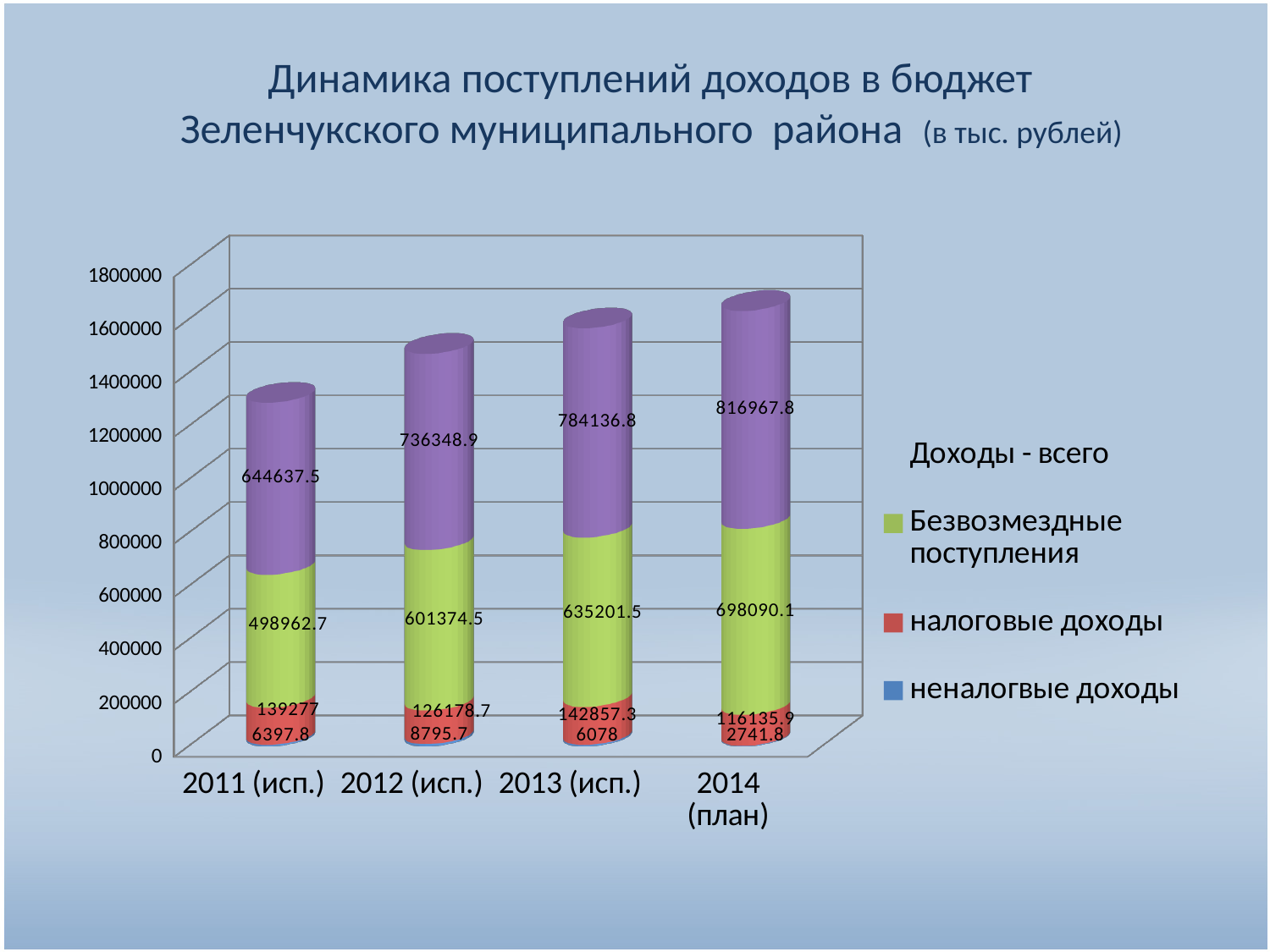
How many series does the legend list? 4 What is the difference between Доходы - всего for 2014 (план) and 2011 (исп.)? 172330.3 What is the value of налоговые доходы for 2012 (исп.)? 126178.7 What is the value of Доходы - всего for 2011 (исп.)? 644637.5 Which year has the lowest value for налоговые доходы? 2014 (план) Which is larger: неналогвые доходы for 2012 (исп.) or for 2013 (исп.)? 2012 (исп.) Which year has the highest value for Доходы - всего? 2014 (план) What is the value of Безвозмездные поступления for 2013 (исп.)? 635201.5 Do the values for Безвозмездные поступления rise or fall from 2011 (исп.) to 2014 (план)? Rise What kind of chart is shown on the slide? Stacked bar chart What is the value of неналогвые доходы for 2014 (план)? 2741.8 How many years are shown on the x axis? 4